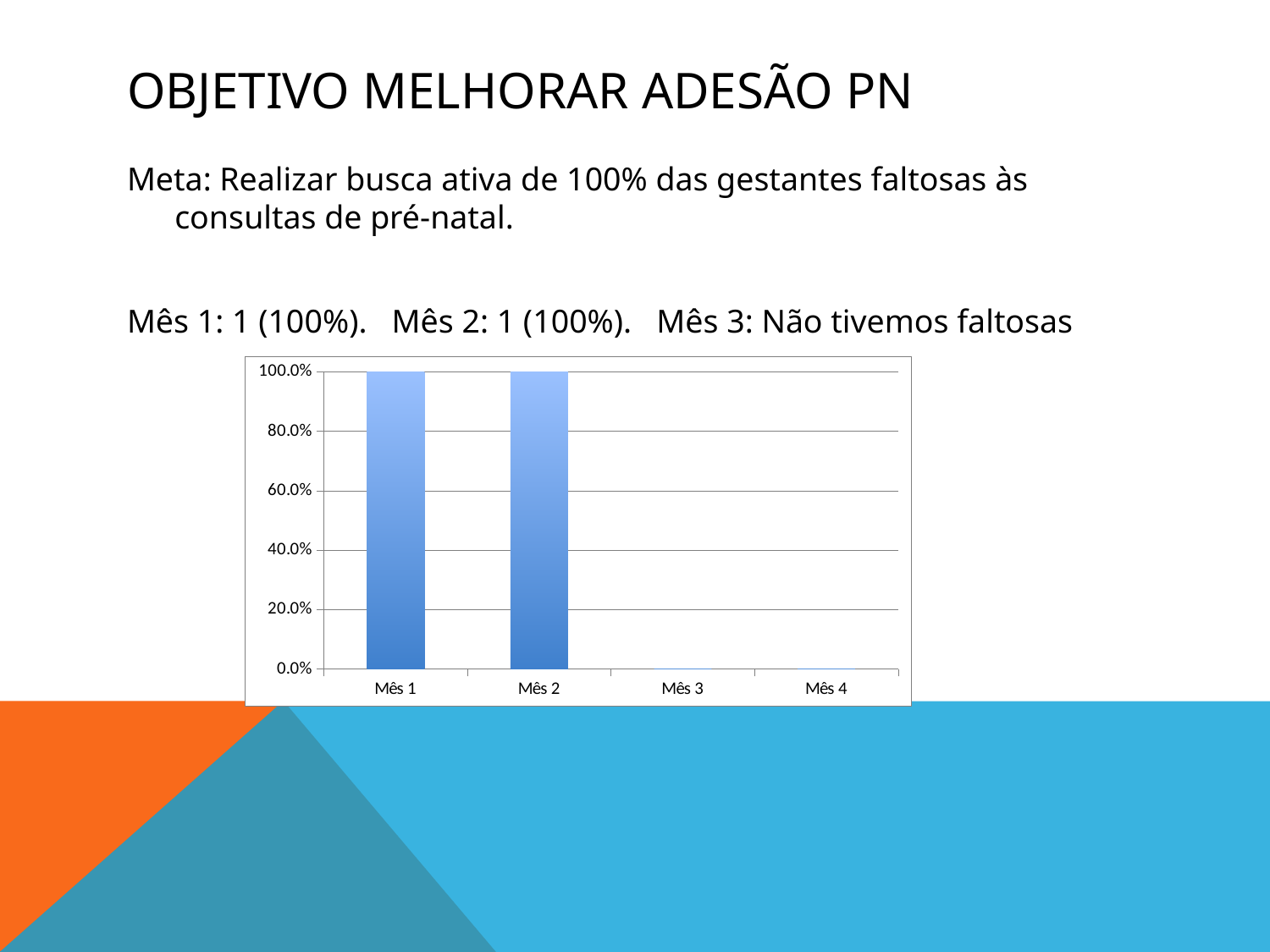
Which is larger, the value for Mês 1 or the value for Mês 3? Mês 1 What is the highest tick label shown on the y axis of the chart? 100.0% Is the value for Mês 2 greater or less than 80.0%? greater What is the difference between the value for Mês 2 and the value for Mês 4? 100.0% What is the value for Mês 3? 0.0% What is the value for Mês 1? 100.0% Do the values rise or fall from Mês 2 to Mês 3? fall What is the value for Mês 4? 0.0% What kind of chart is shown on the slide? Bar chart What is the value for Mês 2? 100.0% How many categories are shown on the x axis of the chart? 4 Is the value for Mês 4 greater or less than 20.0%? less